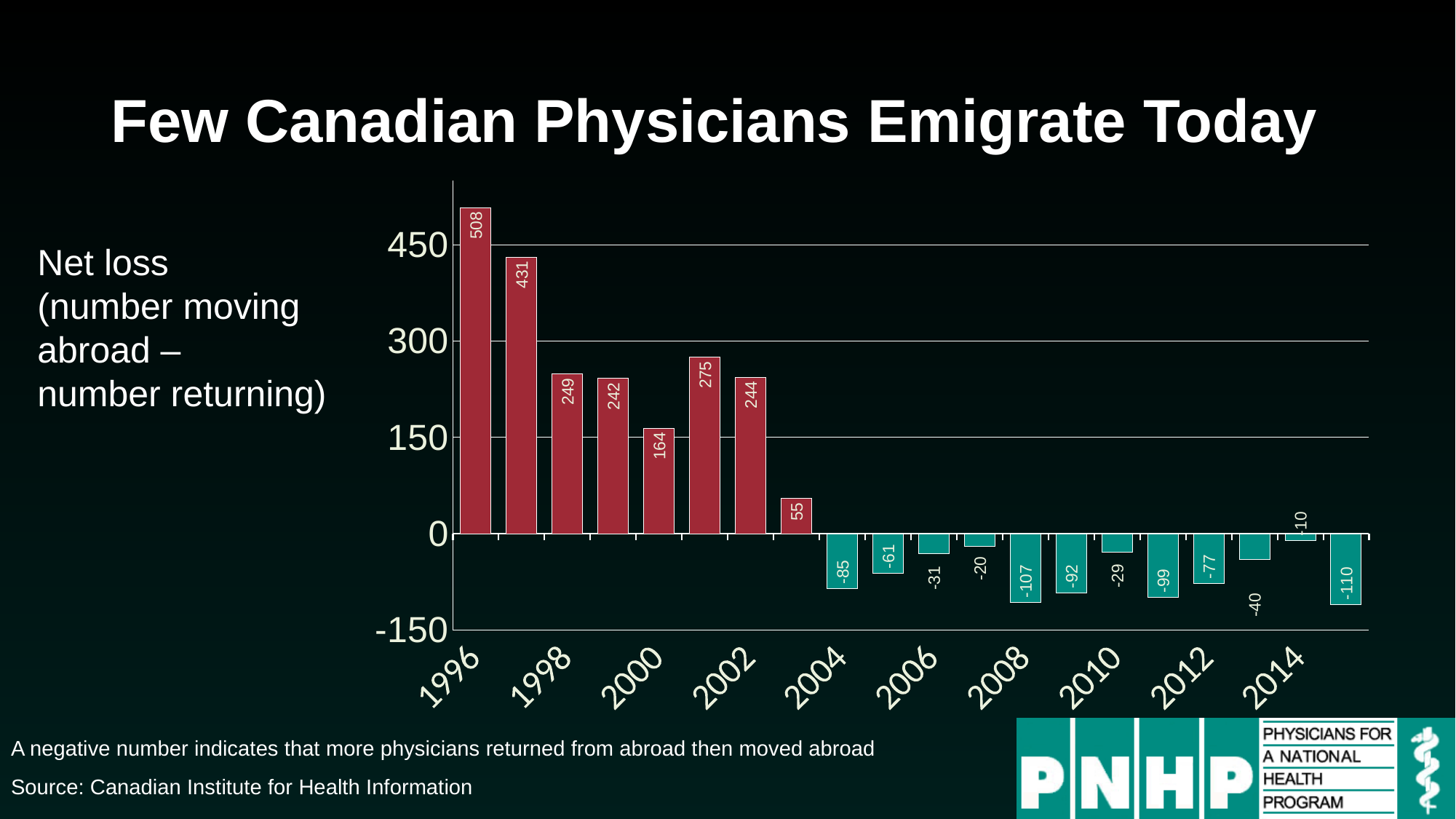
What is the net loss value for 2014? -10 What is the lowest value shown on the chart? -110 What is the title of the slide? Few Canadian Physicians Emigrate Today Which is larger, the value for 2002 or the value for 2000? 2002 What is the net loss value for 1996? 508 What kind of chart is shown on the slide? bar chart How many bars are plotted on the chart? 20 What is the net loss value for 2008? -107 What is the difference between the values for 1996 and 1998? 259 Is the value for 1998 greater or less than 300? less What is the net loss value for 2000? 164 Which year has the highest net loss value? 1996